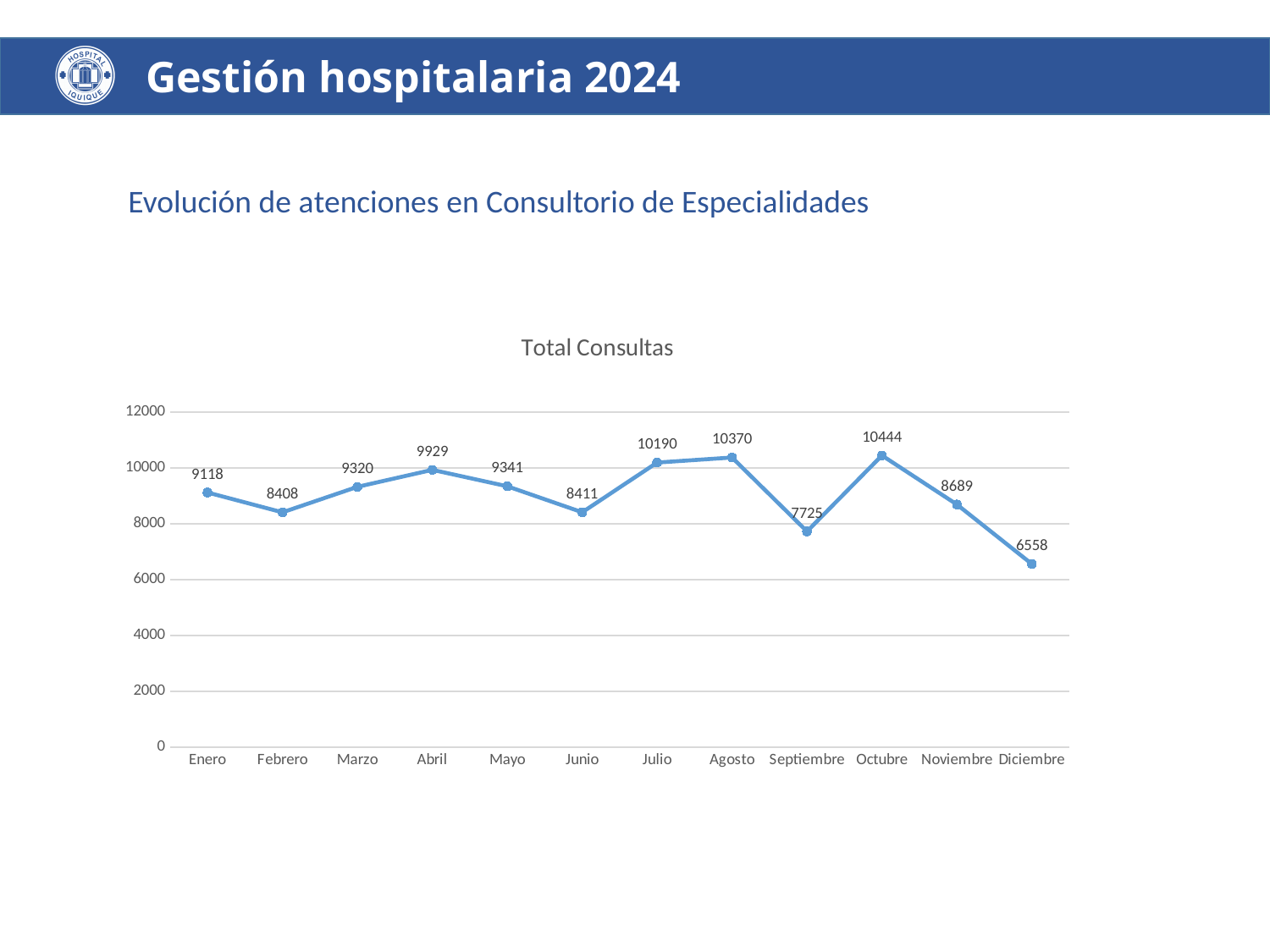
What kind of chart is shown? line chart Which month has the highest value? Octubre What is the value for Abril? 9929 What is the value for Enero? 9118 Which month has the lowest value? Diciembre Is the value for Agosto greater or less than 10000? greater What is the difference between the values for Octubre and Diciembre? 3886 Which is larger, the value for Marzo or the value for Mayo? Mayo What is the difference between the values for Julio and Junio? 1779 How many months are plotted on the x axis? 12 What is the value for Septiembre? 7725 What is the title of the chart? Total Consultas